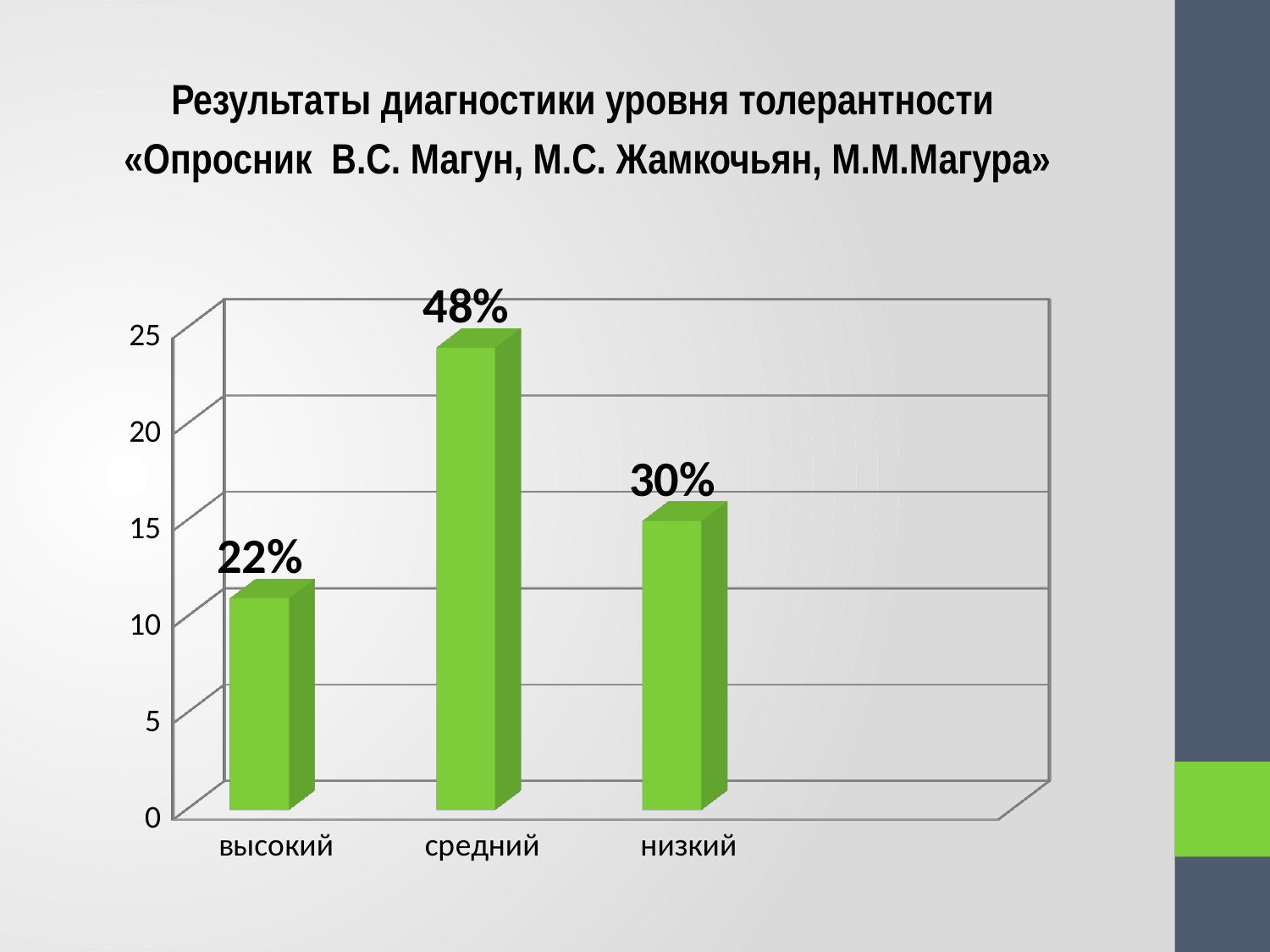
What is the data label shown for the 'низкий' category? 30% What is the data label shown for the 'средний' category? 48% Which is larger, the value for 'низкий' or the value for 'высокий'? низкий Is the bar for 'низкий' greater or less than 20 on the vertical axis? less Which category has the highest value? средний Which category has the lowest value? высокий What is the data label shown for the 'высокий' category? 22% What is the difference between the labelled values for 'средний' and 'высокий'? 26% What colour are the bars in the chart? green How many categories are shown on the x axis? 3 What kind of chart is shown on the slide? bar chart Is the bar for 'средний' greater or less than 20 on the vertical axis? greater